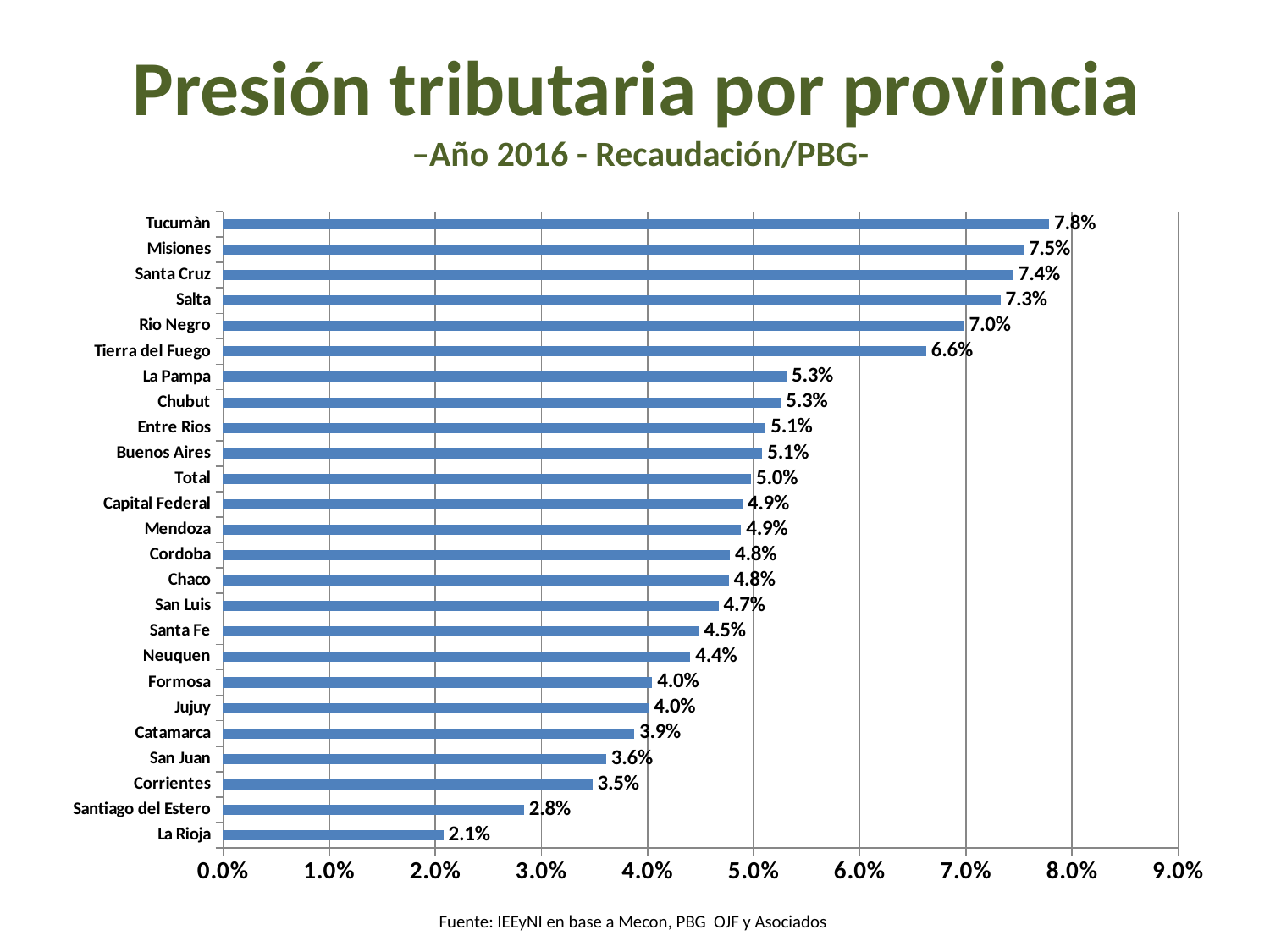
What is the value for Tucumàn? 7.8% What is the value for Total? 5.0% Which province has the lowest value? La Rioja How many bars are plotted in the chart? 25 What is the difference between the values for Rio Negro and Corrientes? 3.5% Is the value for Misiones greater or less than 7.0%? greater What kind of chart is shown on the slide? Bar chart Which is larger, the value for Salta or the value for Mendoza? Salta What is the difference between the values for Tucumàn and La Rioja? 5.7% What is the value for Tierra del Fuego? 6.6% Which province has the highest value? Tucumàn What is the value for Santiago del Estero? 2.8%